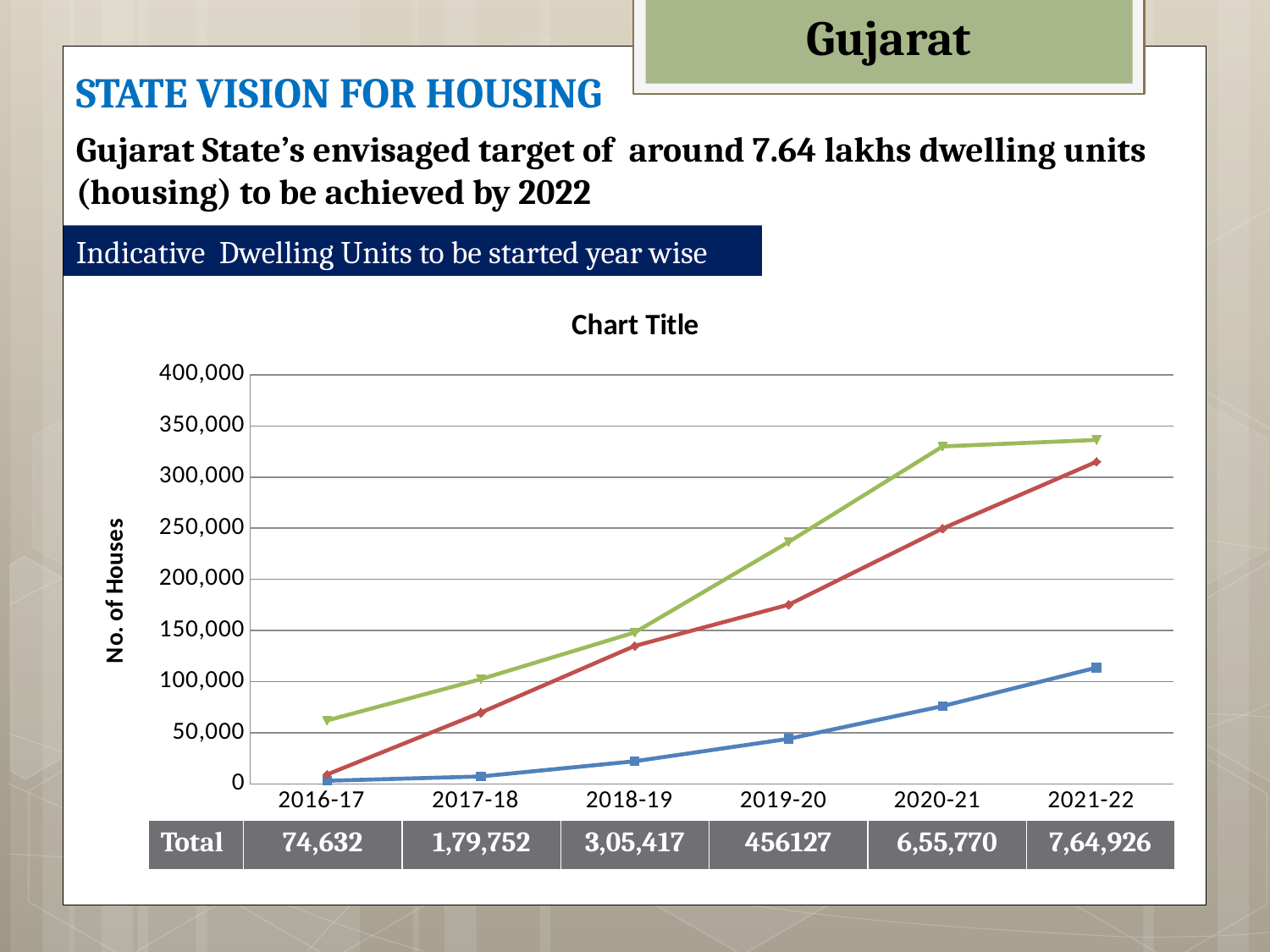
What is the Total value shown for 2021-22? 7,64,926 Is the value of the blue line for 2019-20 greater or less than 50,000? less Is the value of the red line for 2019-20 greater or less than 150,000? greater Do the values of the lines rise or fall from 2016-17 to 2021-22? rise Which year has the lowest Total value in the row below the chart? 2016-17 What kind of chart is shown on the slide? line chart What is the Total value shown for 2019-20? 456127 Is the value of the green line for 2020-21 greater or less than 300,000? greater How many years are shown along the x axis of the chart? 6 Which year has the highest Total value in the row below the chart? 2021-22 At 2021-22, which line is higher, the green line or the blue line? green line What is the Total value shown for 2016-17? 74,632